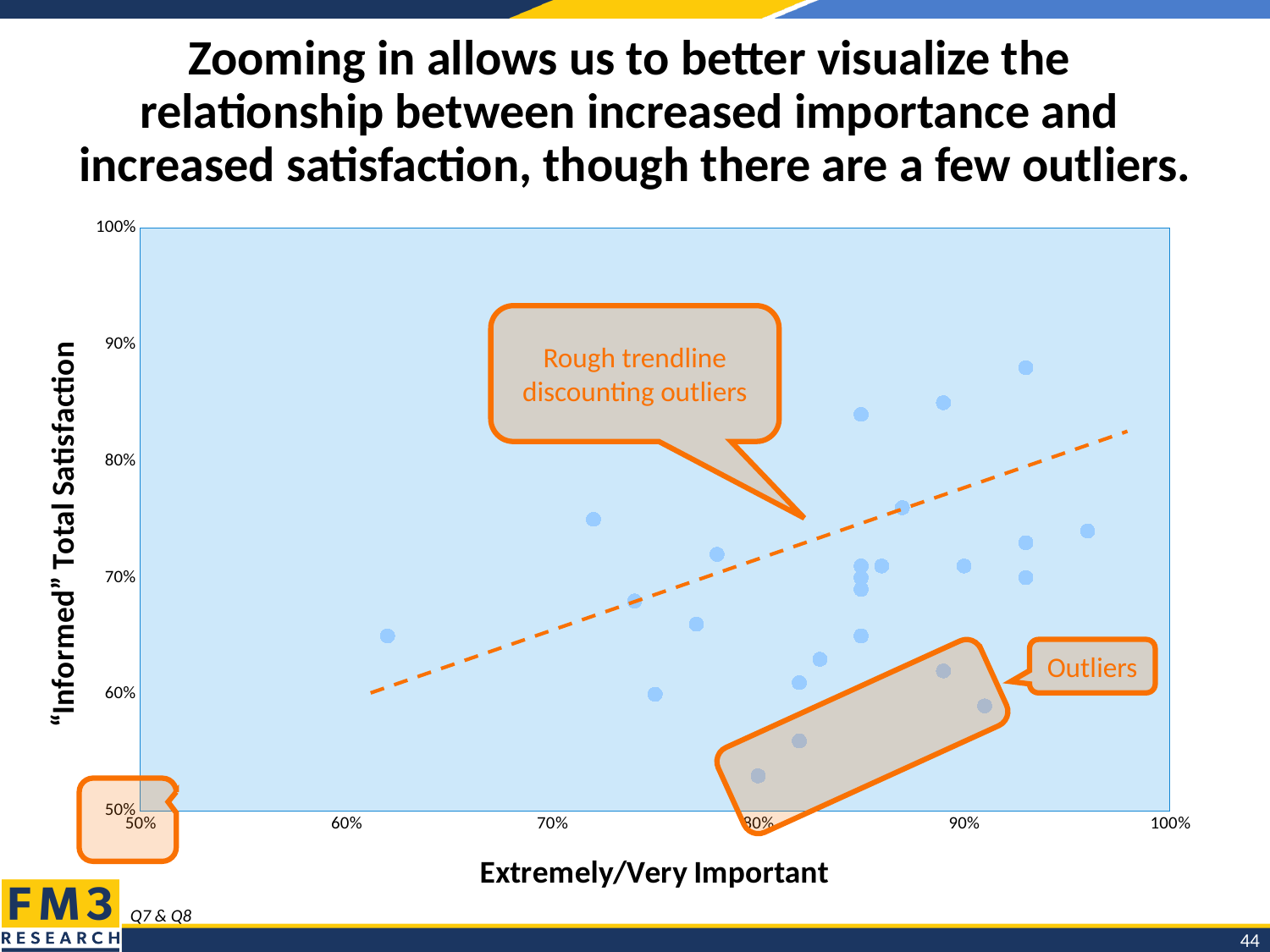
What kind of chart is shown on the slide? Scatter chart What label is attached to the box enclosing the points in the lower right of the chart? Outliers How many points are enclosed in the Outliers box? 4 Is the satisfaction value of the lowest plotted point greater or less than 60%? less According to the dashed trendline, does "Informed" Total Satisfaction rise or fall as Extremely/Very Important increases? Rise Is the importance value of the leftmost plotted point greater or less than 60%? greater What does the large callout pointing at the dashed line say? Rough trendline discounting outliers Is the satisfaction value of the highest plotted point greater or less than 80%? greater